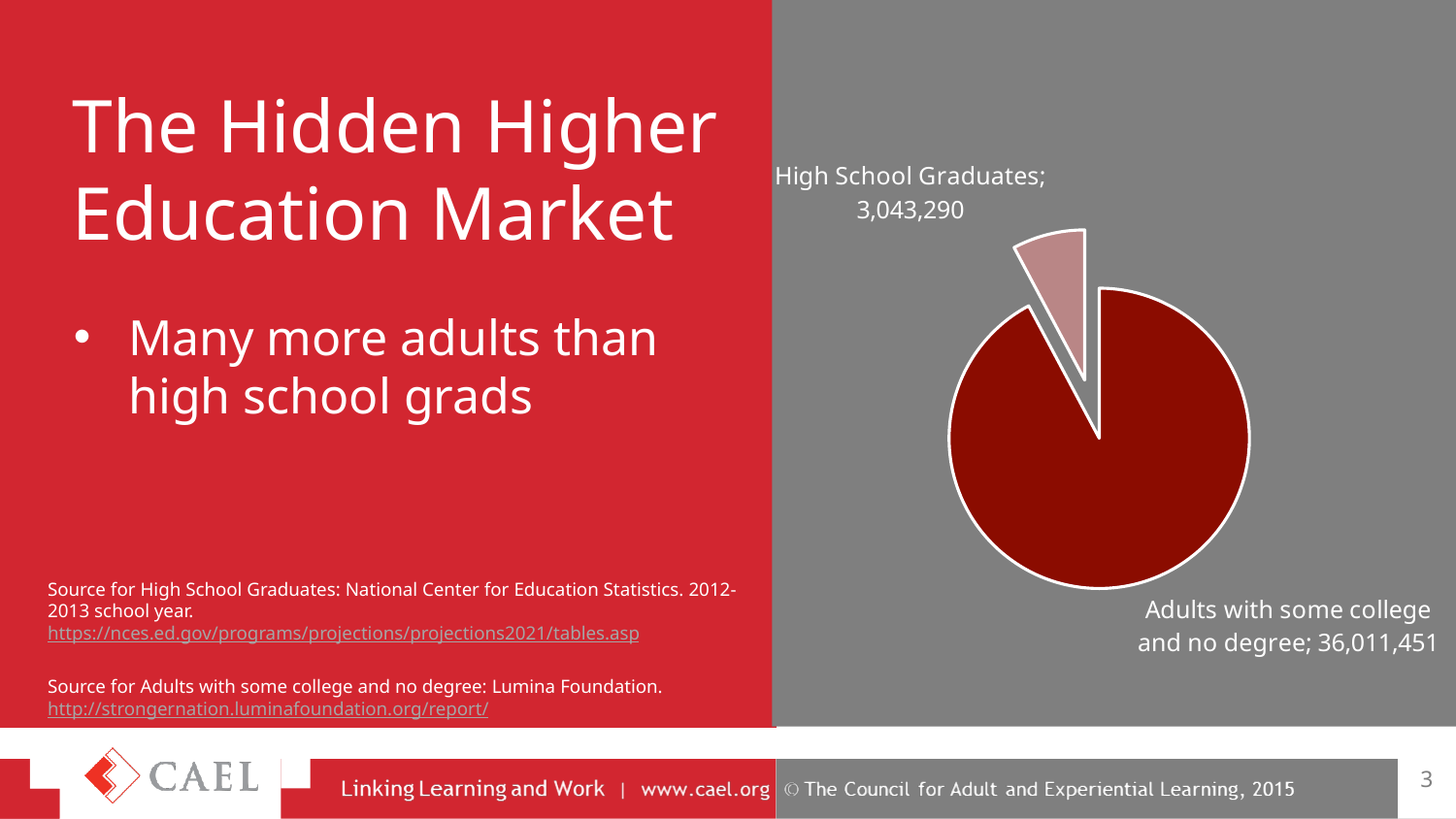
What is the total of the two values shown in the pie chart? 39,054,741 What is the value for High School Graduates in the pie chart? 3,043,290 Which is larger in the pie chart: High School Graduates or Adults with some college and no degree? Adults with some college and no degree How many slices does the pie chart have? 2 What colour is the High School Graduates slice of the pie chart? light pink Which slice of the pie chart is the smallest? High School Graduates What kind of chart is shown on the slide? pie chart What is the value for Adults with some college and no degree in the pie chart? 36,011,451 Which slice of the pie chart is the largest? Adults with some college and no degree What colour is the Adults with some college and no degree slice of the pie chart? dark red What is the difference between the value for Adults with some college and no degree and the value for High School Graduates? 32,968,161